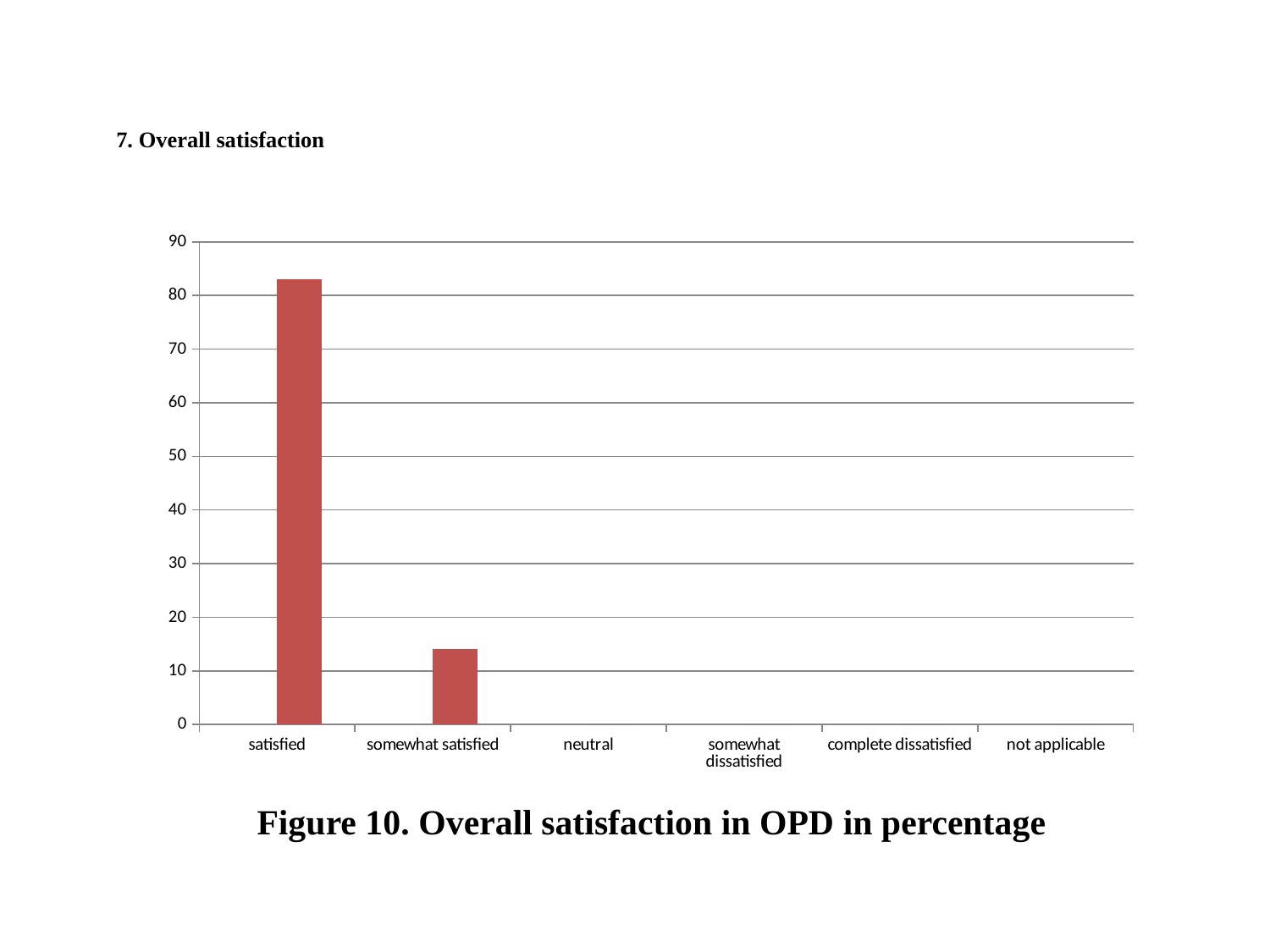
Do the values generally rise or fall moving from left to right along the x axis? fall Is the value for satisfied greater or less than 80? greater How many categories in the chart have a visible bar above zero? 2 What colour are the bars in the chart? red Is the value for somewhat satisfied greater or less than 20? less Is the value for satisfied greater or less than 90? less How many categories are shown on the x axis of the chart? 6 What is the figure caption below the chart? Figure 10. Overall satisfaction in OPD in percentage Which category has the highest value in the chart? satisfied What kind of chart is shown on the slide? bar chart Which is larger, the value for satisfied or the value for somewhat satisfied? satisfied